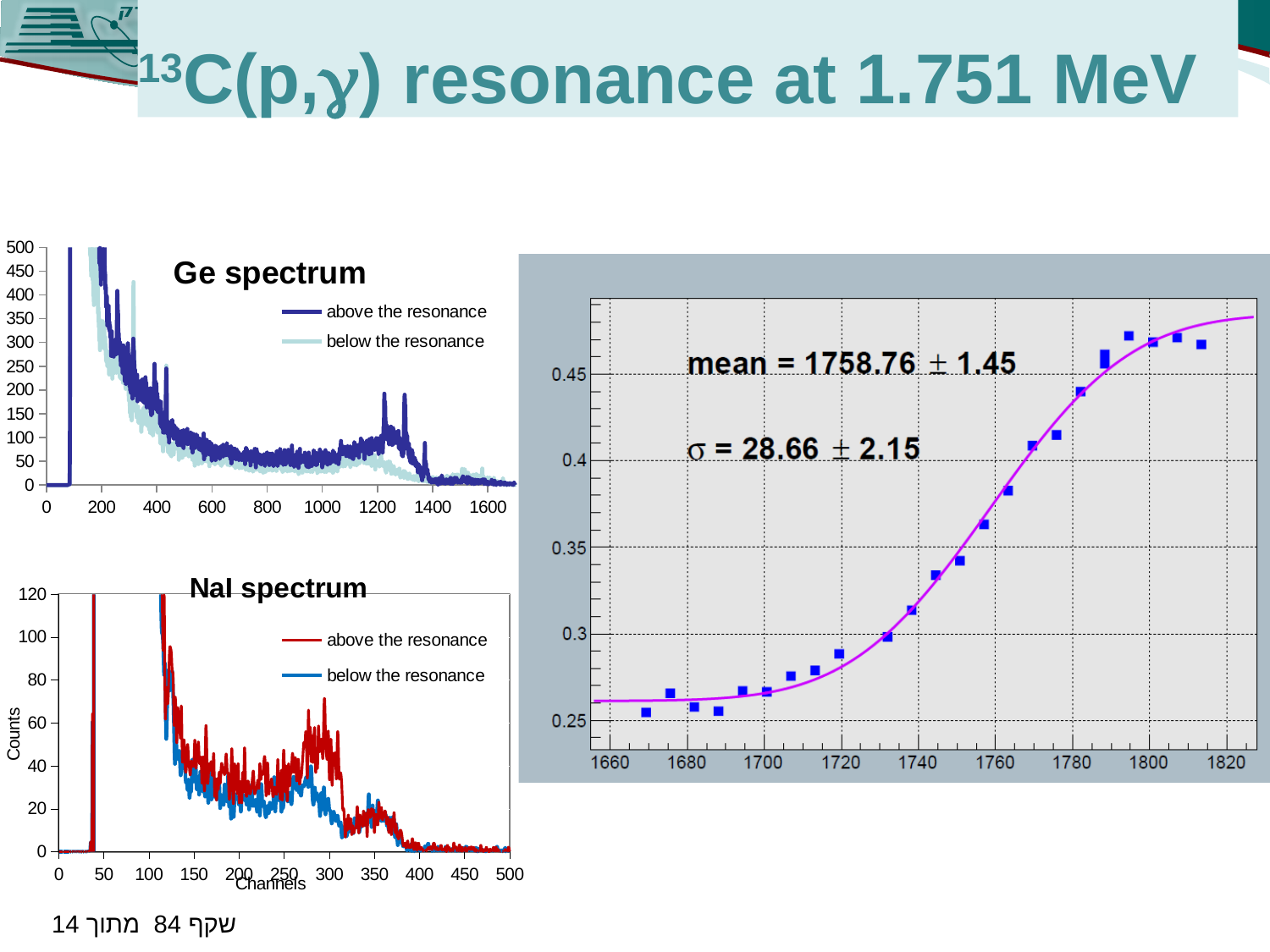
How many series does the legend of the Ge spectrum list? 2 How many series does the legend of the NaI spectrum list? 2 In the chart on the right, do the plotted values rise or fall as the x-axis increases from 1660 to 1820? rise In the NaI spectrum, which series is higher around channel 280, 'above the resonance' or 'below the resonance'? above the resonance What are the two legend entries of the Ge spectrum? above the resonance, below the resonance In the NaI spectrum, is the 'above the resonance' value around channel 350 greater or less than 40? less In the Ge spectrum, is the 'above the resonance' value around channel 800 greater or less than 200? less In the chart on the right, what is the fitted mean value printed on the plot? 1758.76 ± 1.45 What is the x-axis label of the NaI spectrum? Channels In the chart on the right, is the value at x = 1700 greater or less than 0.3? less In the chart on the right, what is the fitted σ value printed on the plot? 28.66 ± 2.15 What kind of chart is the Ge spectrum? line chart